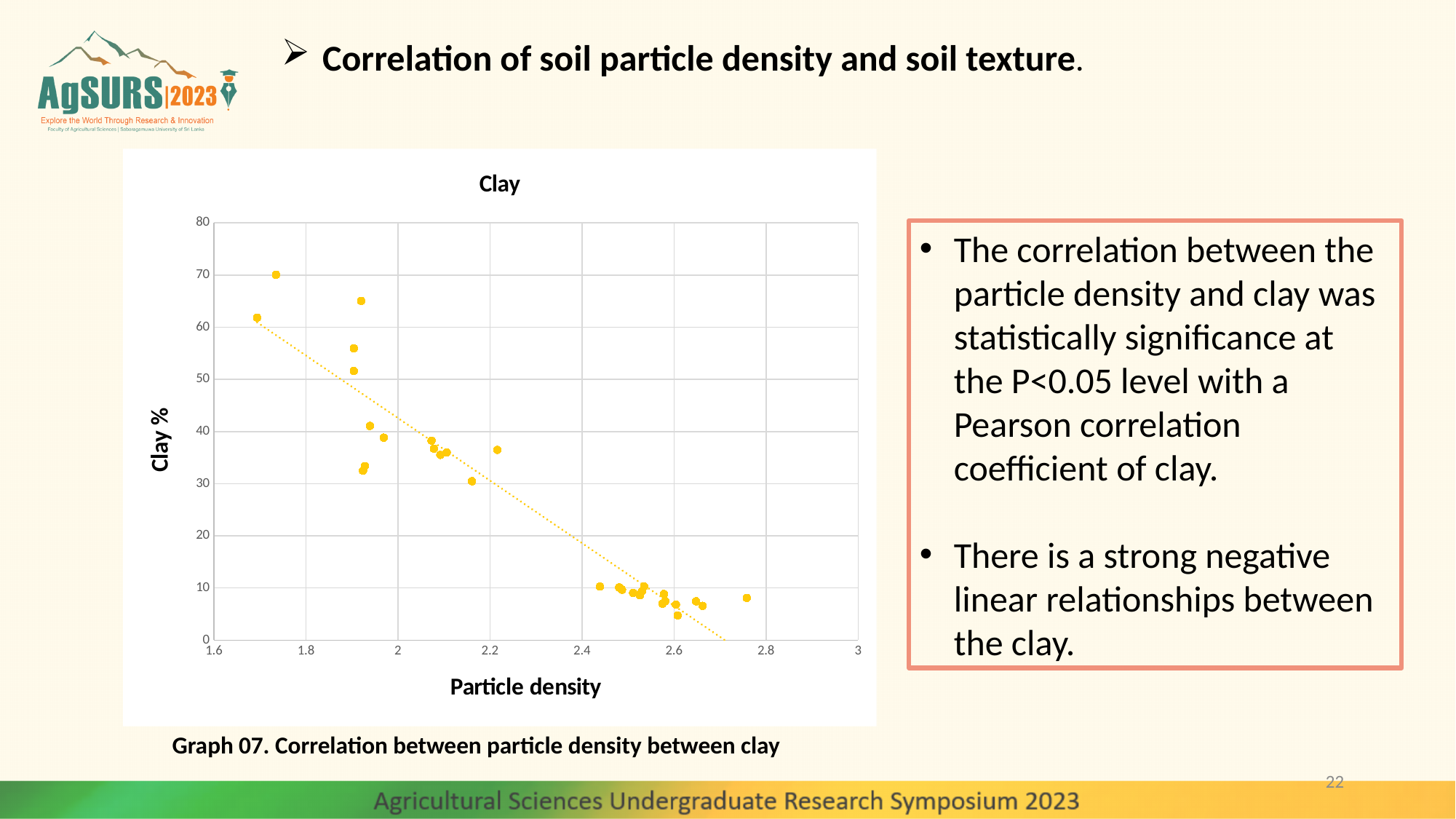
Which has the higher clay %: the point at particle density about 1.73 or the point at particle density about 2.2? The point at about 1.73 Is the highest clay % value plotted on the chart greater or less than 60? greater What kind of chart is shown on the slide? Scatter chart Are the clay % values for points with particle density above 2.4 greater or less than 20? less Is the clay % for the point at a particle density of about 2.2 greater or less than 30? greater What is the title of the chart? Clay What is the label of the horizontal axis of the chart? Particle density As particle density increases along the x axis, do the clay % values generally rise or fall? Fall